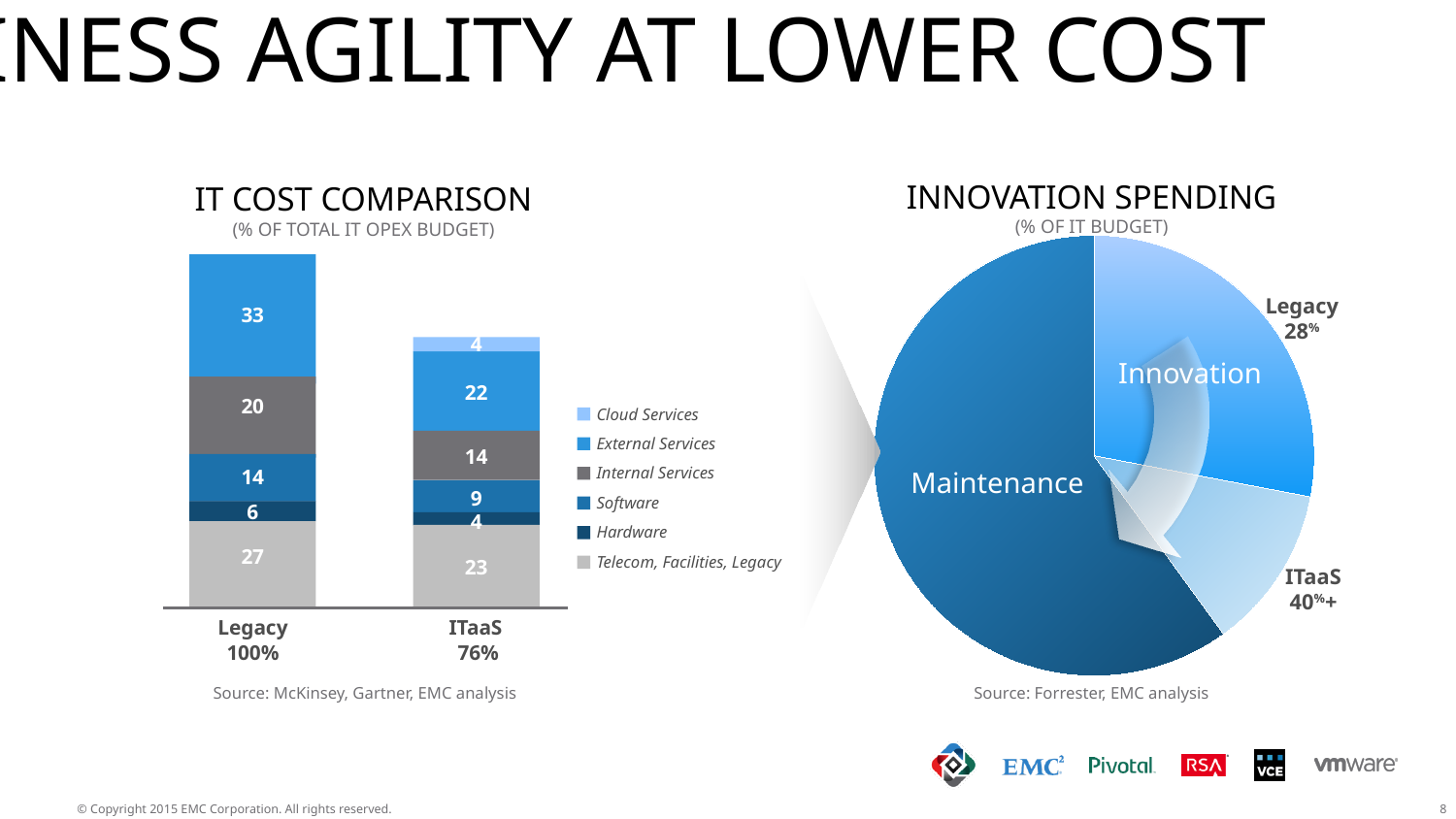
In the IT COST COMPARISON chart, what is the difference between the Internal Services values for Legacy and ITaaS? 6 How many series does the legend of the IT COST COMPARISON chart list? 6 In the IT COST COMPARISON chart, which segment of the Legacy bar is the smallest? Hardware What kind of chart is the IT COST COMPARISON chart? Stacked bar chart In the INNOVATION SPENDING chart, what percentage is shown for ITaaS? 40%+ In the IT COST COMPARISON chart, what is the Cloud Services value for the ITaaS bar? 4 In the INNOVATION SPENDING chart, what percentage is shown for Legacy? 28% In the IT COST COMPARISON chart, which bar has the larger Software value, Legacy or ITaaS? Legacy In the IT COST COMPARISON chart, what is the Telecom, Facilities, Legacy value for the ITaaS bar? 23 In the IT COST COMPARISON chart, what is the total shown for the Legacy bar? 100% In the IT COST COMPARISON chart, what is the total shown for the ITaaS bar? 76% In the IT COST COMPARISON chart, what is the External Services value for the Legacy bar? 33